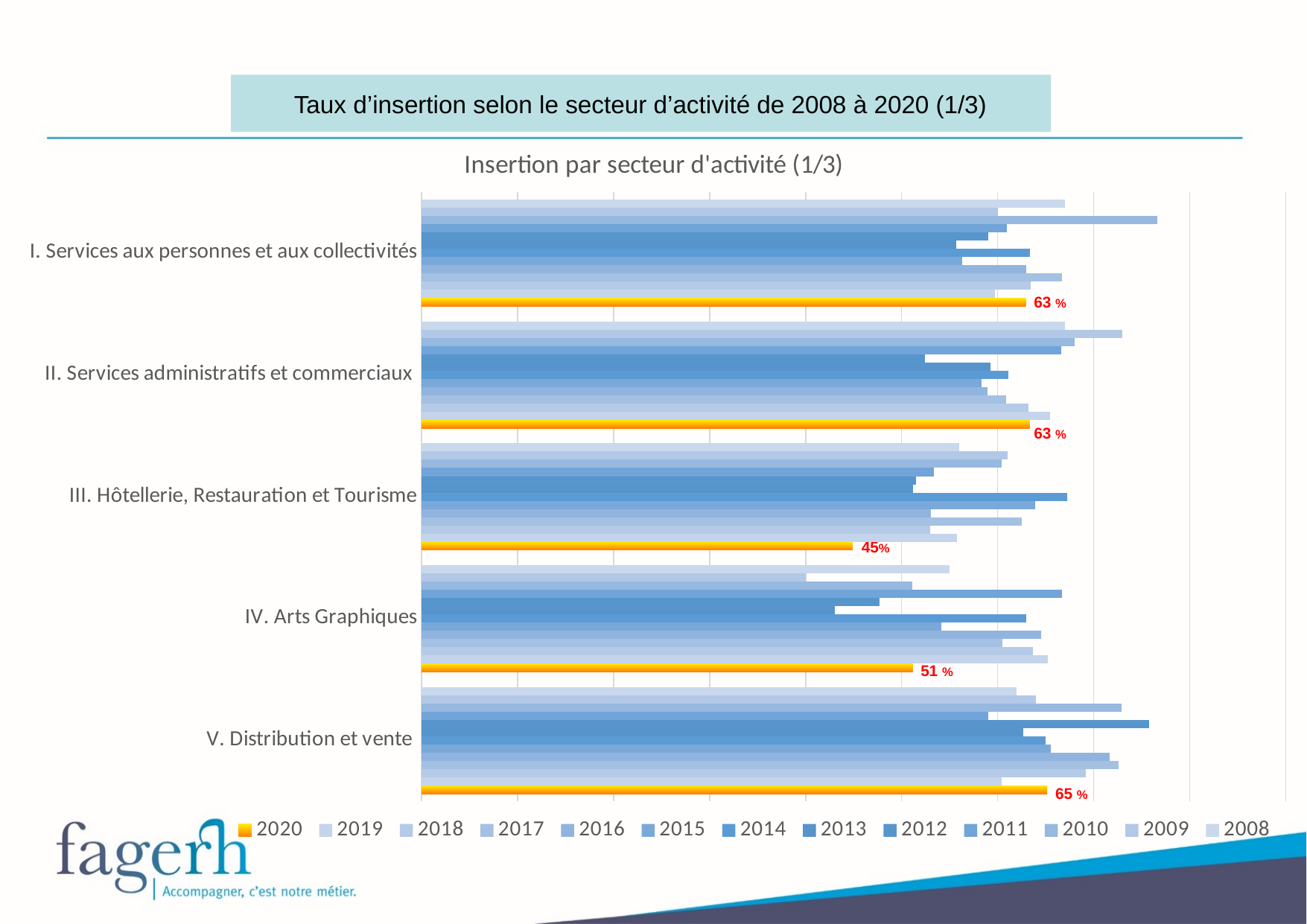
How many sectors are shown on the chart? 5 What type of chart is shown on the slide? Bar chart Which sector has the lowest 2020 insertion rate? III. Hôtellerie, Restauration et Tourisme What is the difference between the 2020 insertion rates of V. Distribution et vente and III. Hôtellerie, Restauration et Tourisme? 20 percentage points What is the 2020 insertion rate for III. Hôtellerie, Restauration et Tourisme? 45% In 2020, which has the larger insertion rate: IV. Arts Graphiques or III. Hôtellerie, Restauration et Tourisme? IV. Arts Graphiques What is the 2020 insertion rate for IV. Arts Graphiques? 51 % How many years (series) does the legend list? 13 What is the 2020 insertion rate for I. Services aux personnes et aux collectivités? 63 % What is the title of the chart? Insertion par secteur d'activité (1/3) What is the 2020 insertion rate for V. Distribution et vente? 65 % Which sector has the highest 2020 insertion rate? V. Distribution et vente